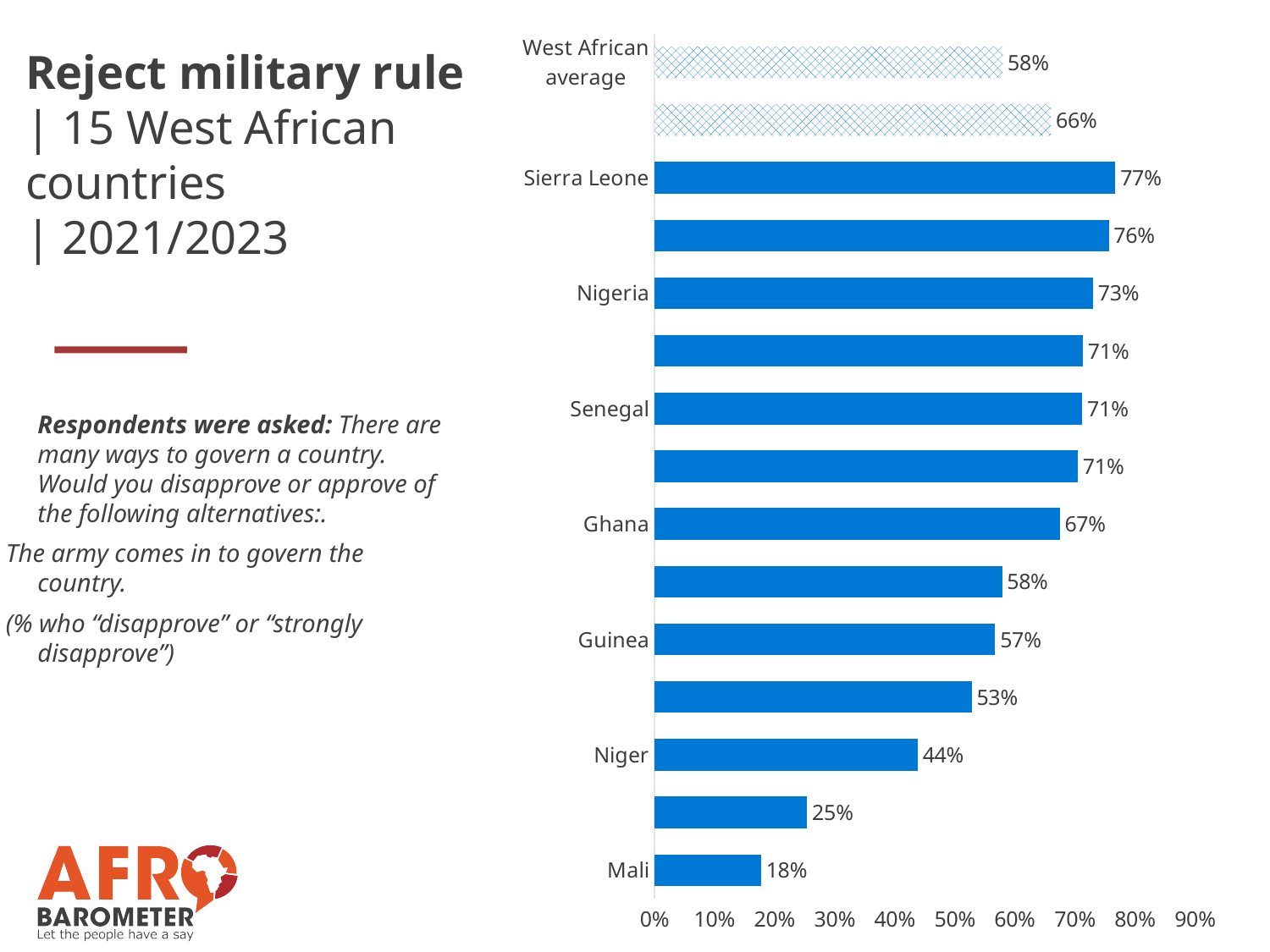
Which country has the highest share rejecting military rule? Sierra Leone Which country has the lowest share rejecting military rule? Mali What is the West African average for rejecting military rule? 58% What percentage of respondents in Sierra Leone reject military rule? 77% What percentage is shown for Mali? 18% What is the value shown for Niger? 44% Is the value for Guinea greater or less than the West African average? less What type of chart is shown on the slide? Bar chart What is the value shown for Nigeria? 73% Which is larger, the value for Senegal or the value for Niger? Senegal How much higher is Ghana's value than Guinea's? 10 percentage points What is the difference between Sierra Leone's value and Mali's value? 59 percentage points